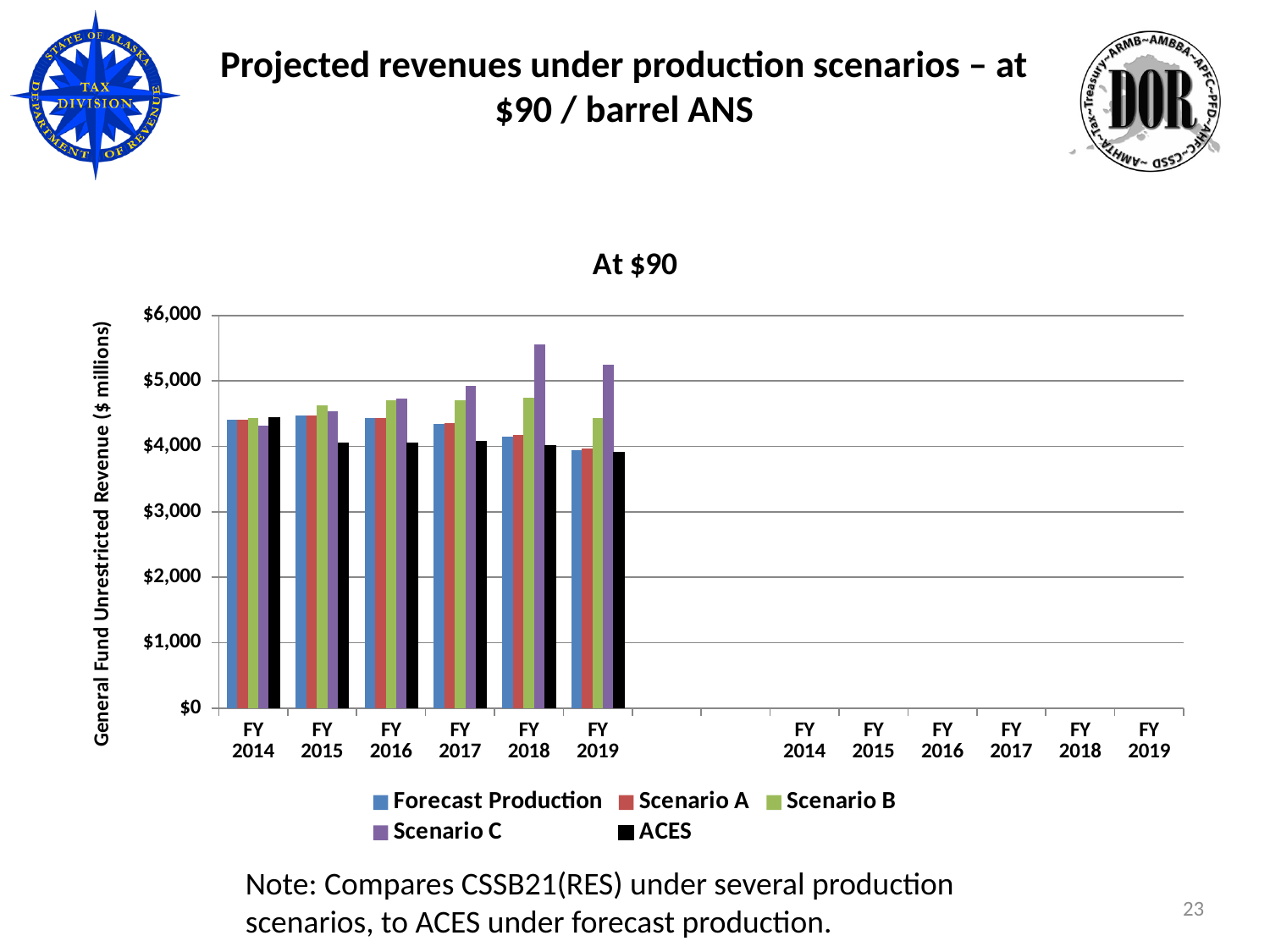
Is the value for Forecast Production in FY 2014 greater or less than $4,000? greater Is the ACES value in FY 2019 higher or lower than the ACES value in FY 2014? lower Which series is drawn in black in the legend? ACES What is the title of the chart? At $90 How many series does the legend list? 5 How many fiscal years have bars plotted in the chart? 6 What kind of chart is shown on the slide? bar chart Is the value for Scenario B in FY 2017 greater or less than $5,000? less Which series has the tallest bar in FY 2018? Scenario C In which fiscal year does the tallest bar in the chart appear? FY 2018 In FY 2019, which is larger: Scenario B or Forecast Production? Scenario B Is the value for Scenario C in FY 2018 greater or less than $5,000? greater